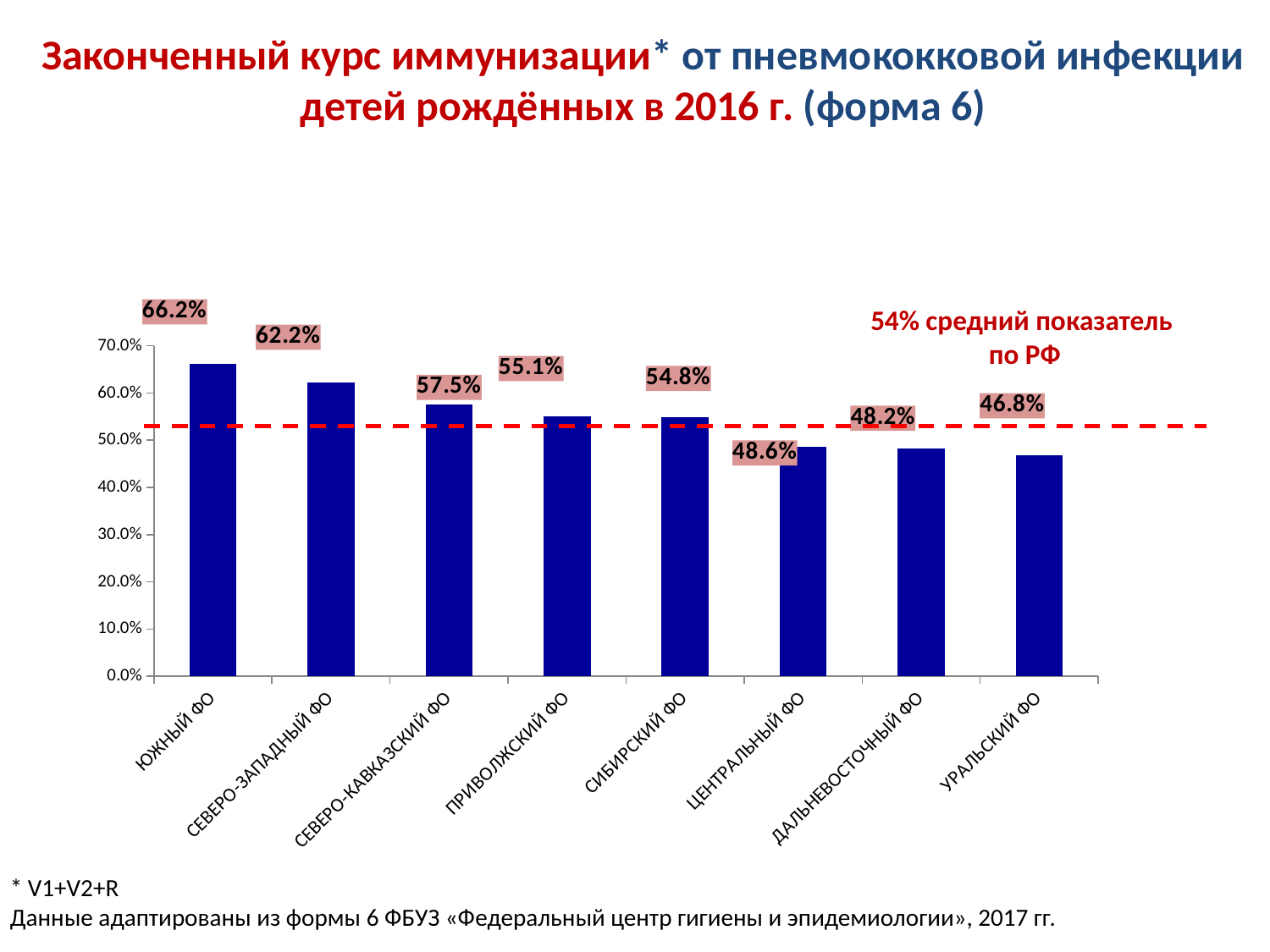
How many federal districts are shown on the chart? 8 What is the value for УРАЛЬСКИЙ ФО? 46.8% Which federal district has the highest value? ЮЖНЫЙ ФО What kind of chart is shown on the slide? bar chart Is the value for ДАЛЬНЕВОСТОЧНЫЙ ФО greater or less than 50.0%? less What is the value for ЮЖНЫЙ ФО? 66.2% Do the values rise or fall from left to right along the x axis? fall Which federal district has the lowest value? УРАЛЬСКИЙ ФО What is the difference between the values for ЮЖНЫЙ ФО and СЕВЕРО-ЗАПАДНЫЙ ФО? 4.0% Which is larger, the value for СЕВЕРО-КАВКАЗСКИЙ ФО or the value for ЦЕНТРАЛЬНЫЙ ФО? СЕВЕРО-КАВКАЗСКИЙ ФО What is the value for СИБИРСКИЙ ФО? 54.8% What average value for the Russian Federation (по РФ) is indicated by the dashed line annotation? 54%